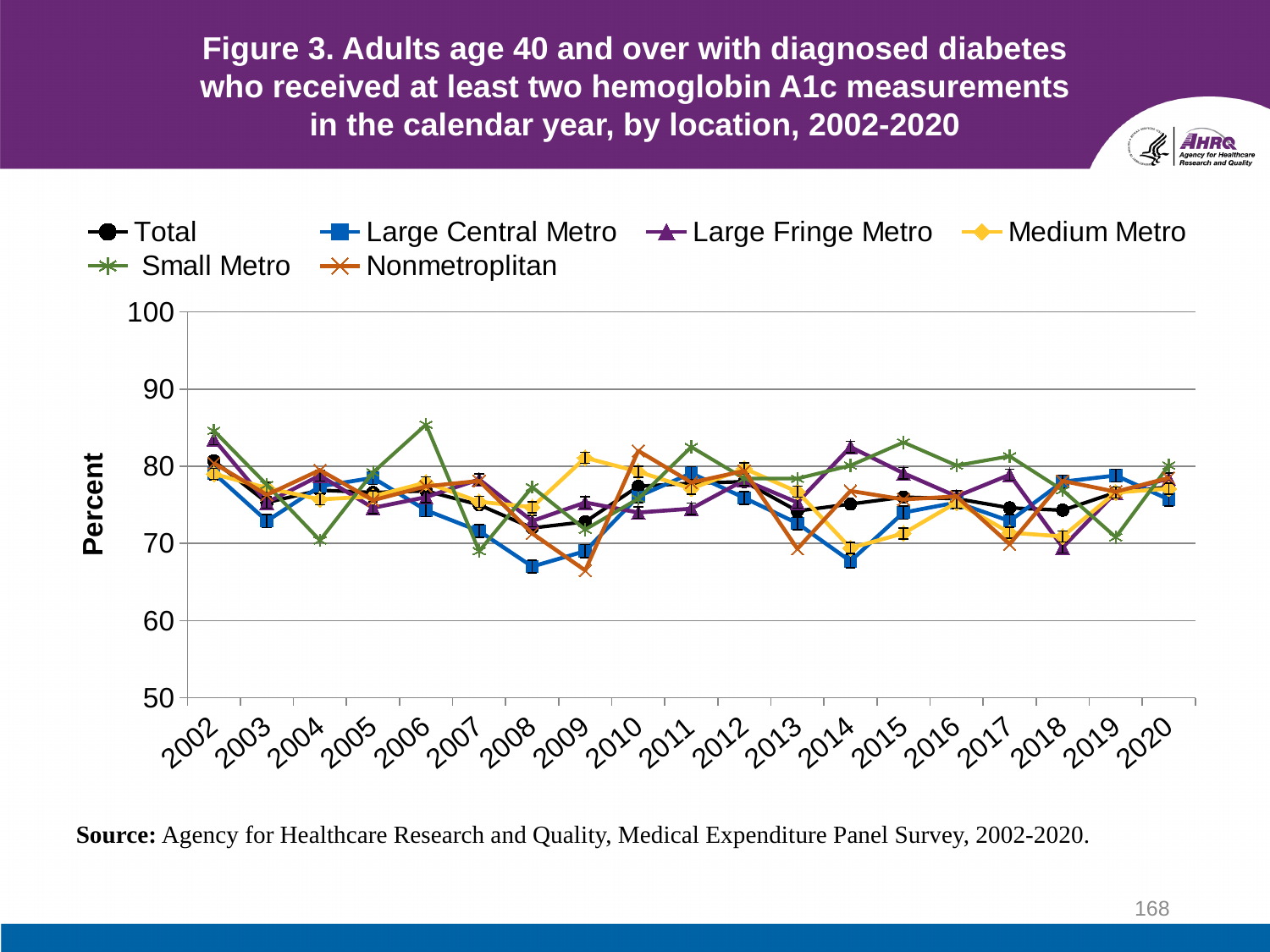
What is the label on the vertical axis? Percent How many years are plotted along the x axis? 19 Is the value for Large Fringe Metro in 2002 greater or less than 80? greater Which series is represented by the green line with star markers? Small Metro Is the value for Large Central Metro in 2008 greater or less than 70? less Is the value for Small Metro in 2006 greater or less than 80? greater What kind of chart is shown on the slide? Line chart Which series has the lowest value in 2008? Large Central Metro In 2008, which is higher: Medium Metro or Large Central Metro? Medium Metro How many series does the legend list? 6 Which series has the highest value in 2006? Small Metro